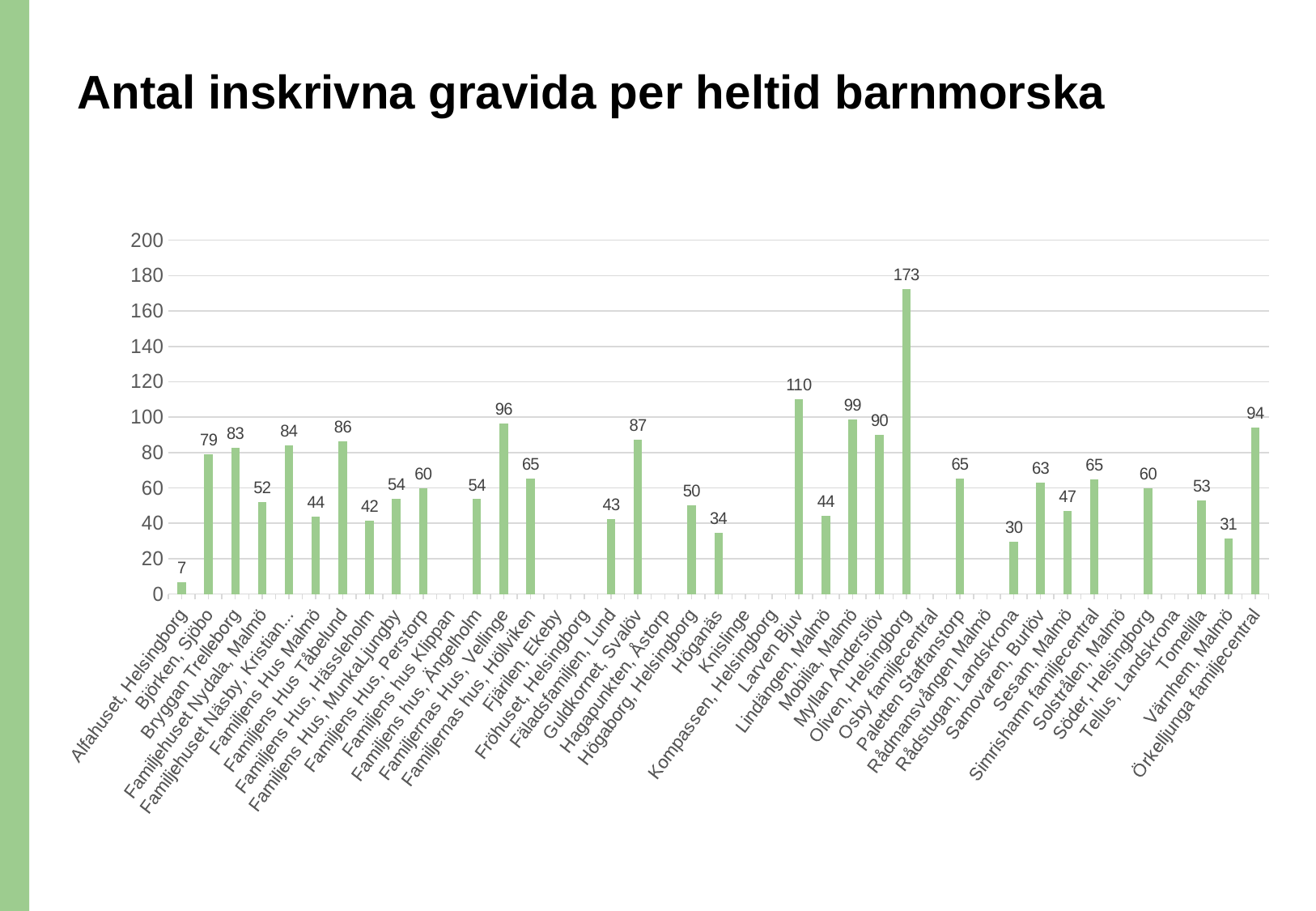
What is the difference between the values for Oliven, Helsingborg and Larven Bjuv? 63 What is the value for Rådstugan, Landskrona? 30 What is the title of the chart? Antal inskrivna gravida per heltid barnmorska What is the value for Örkelljunga familjecentral? 94 Which is larger, the value for Mobilia, Malmö or the value for Myllan Anderslöv? Mobilia, Malmö What is the value for Larven Bjuv? 110 What kind of chart is shown on the slide? Bar chart Which category has the highest value? Oliven, Helsingborg Which category has the lowest value? Alfahuset, Helsingborg Is the value for Guldkornet, Svalöv greater or less than 100? less What is the value for Familjens hus, Vellinge? 96 What is the difference between the values for Björken, Sjöbo and Höganäs? 45